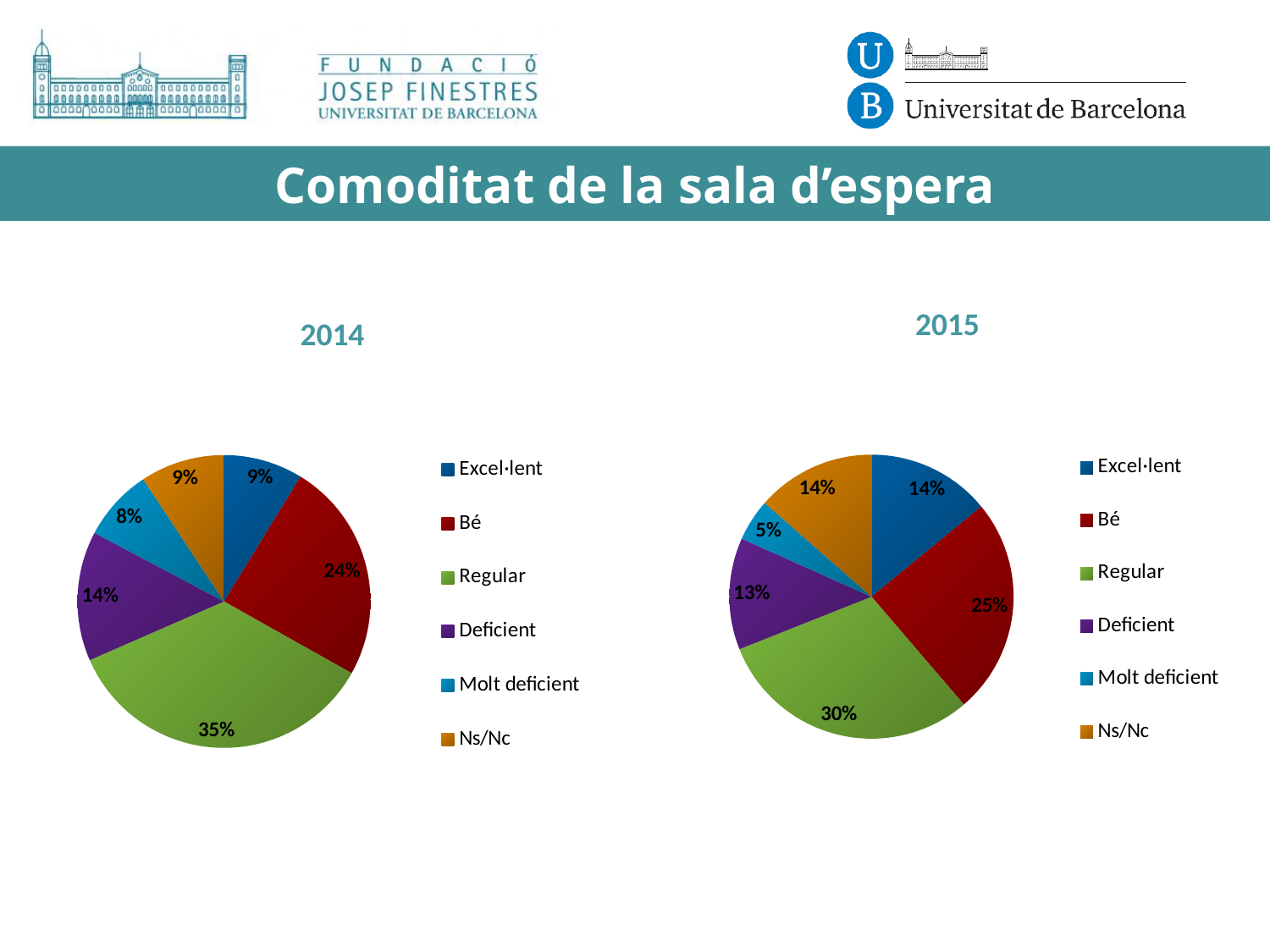
In the 2015 chart, what share does Molt deficient have? 5% In the 2015 chart, what is the difference between the Regular and Bé shares? 5% What kind of chart is the 2014 chart? Pie chart How many categories does the legend of the 2015 chart list? 6 In the 2014 chart, what share does Regular have? 35% In the 2015 chart, what share does Bé have? 25% In the 2015 chart, which category has the smallest slice? Molt deficient What is the title of the slide? Comoditat de la sala d'espera In the 2014 chart, what share does Deficient have? 14% In the 2014 chart, which category has the largest slice? Regular In the 2014 chart, which is larger, Bé or Deficient? Bé In the 2014 chart, which category has the smallest slice? Molt deficient